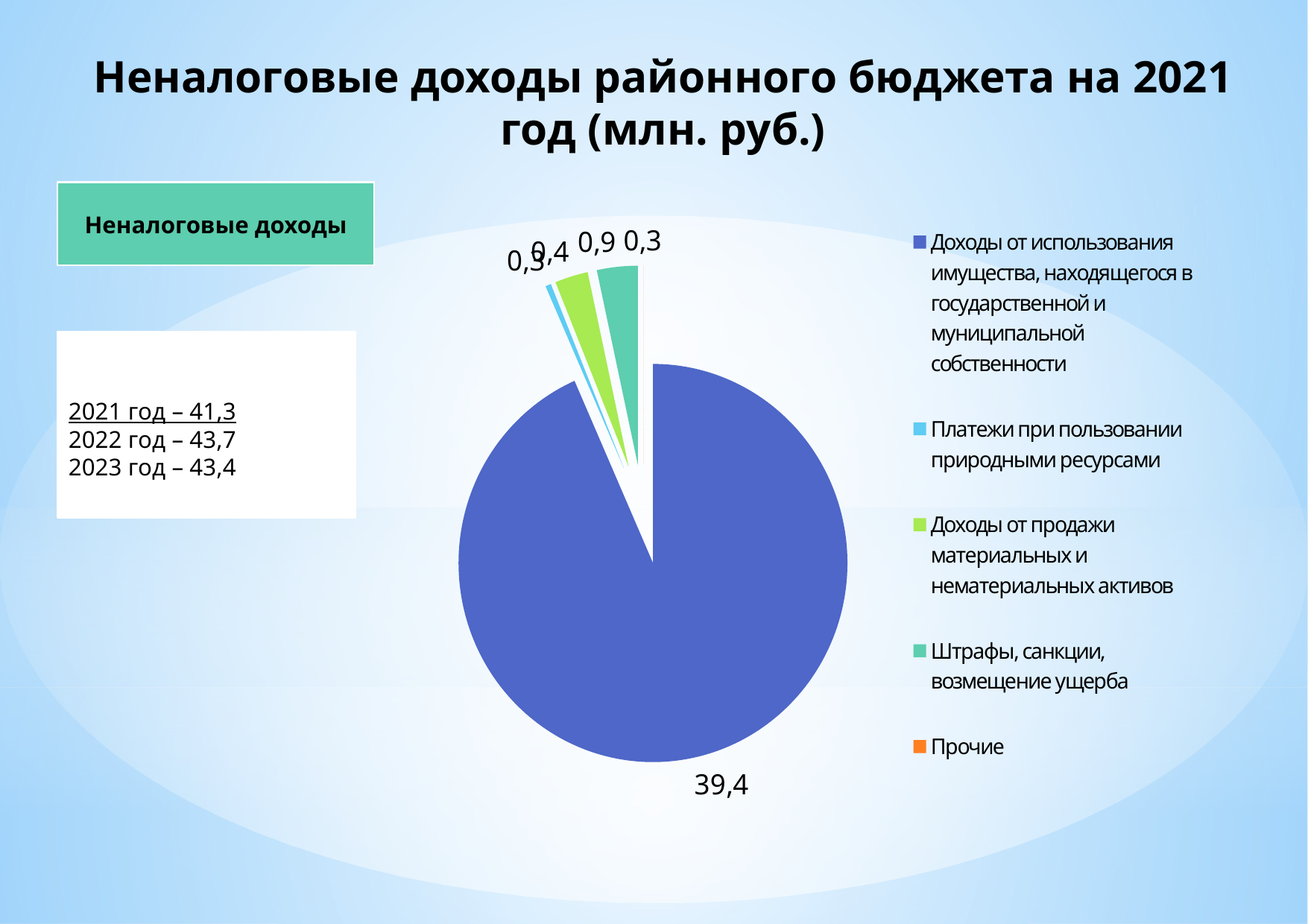
What is the difference between the values for 'Доходы от продажи материальных и нематериальных активов' and 'Штрафы, санкции, возмещение ущерба'? 0,5 What is the value of the slice for 'Штрафы, санкции, возмещение ущерба'? 0,9 What is the value of the slice for 'Доходы от использования имущества, находящегося в государственной и муниципальной собственности'? 39,4 What is the value of the slice for 'Доходы от продажи материальных и нематериальных активов'? 0,4 How many categories are listed in the chart legend? 5 Which is larger: the slice for 'Доходы от продажи материальных и нематериальных активов' or the slice for 'Штрафы, санкции, возмещение ущерба'? Штрафы, санкции, возмещение ущерба Which category has the largest slice in the pie chart? Доходы от использования имущества, находящегося в государственной и муниципальной собственности Which legend entry is shown in orange? Прочие What type of chart is shown on the slide? Pie chart What colour is the slice for 'Штрафы, санкции, возмещение ущерба'? Teal (green-blue)